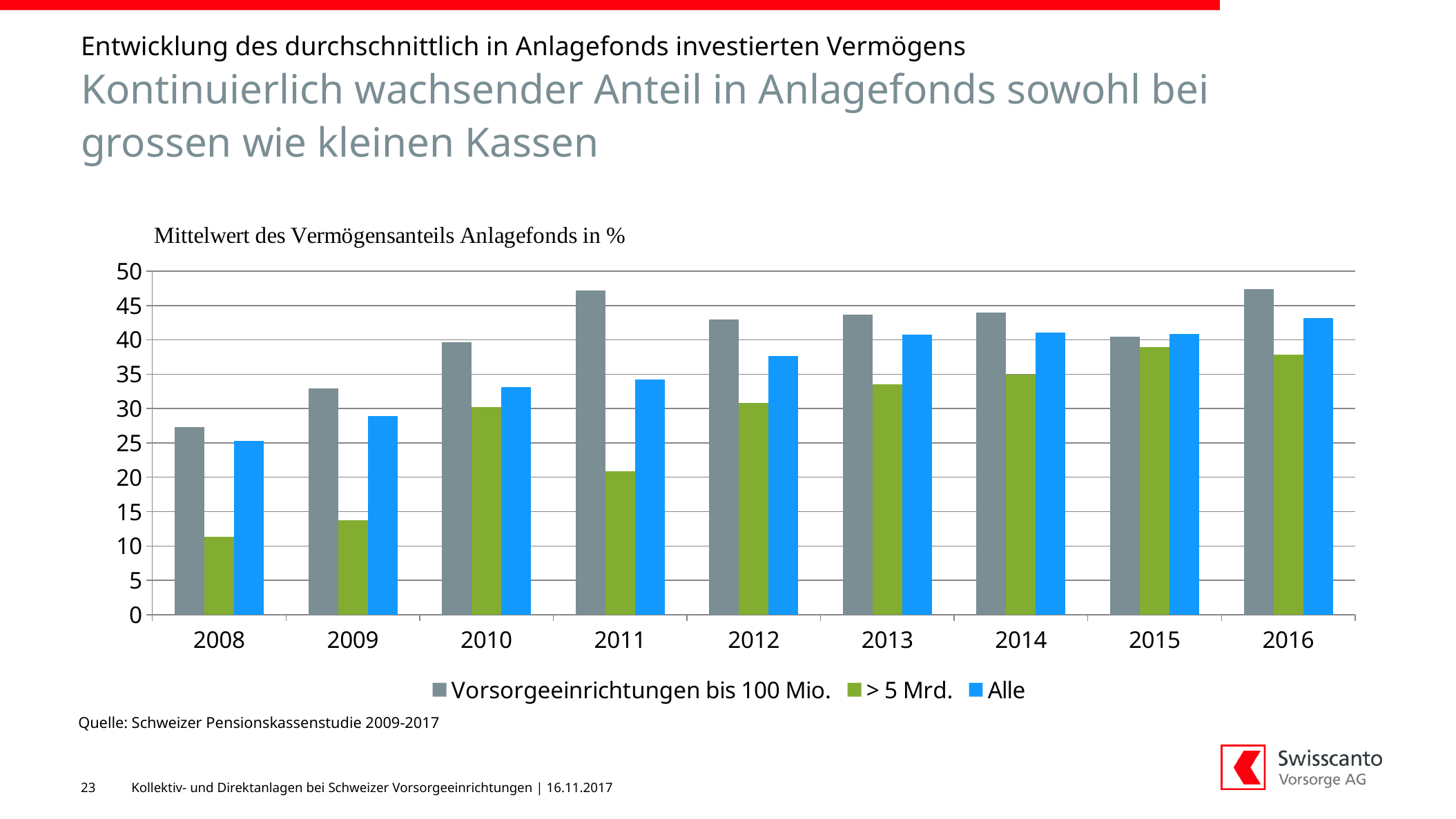
Is the value for 'Alle' in 2016 greater or less than 40? greater How many series does the legend list? 3 Which year has the lowest value for the '> 5 Mrd.' series? 2008 What is the title printed above the chart? Mittelwert des Vermögensanteils Anlagefonds in % Is the value for 'Vorsorgeeinrichtungen bis 100 Mio.' in 2012 greater or less than 40? greater In 2011, which is larger: the value for 'Vorsorgeeinrichtungen bis 100 Mio.' or the value for 'Alle'? Vorsorgeeinrichtungen bis 100 Mio. Does the 'Alle' series generally rise or fall from 2008 to 2016? rise Is the value for '> 5 Mrd.' in 2011 greater or less than 25? less How many years are shown on the x axis? 9 Which year has the highest value for the 'Alle' series? 2016 Which year has the lowest value for the 'Vorsorgeeinrichtungen bis 100 Mio.' series? 2008 What kind of chart is shown on the slide? bar chart